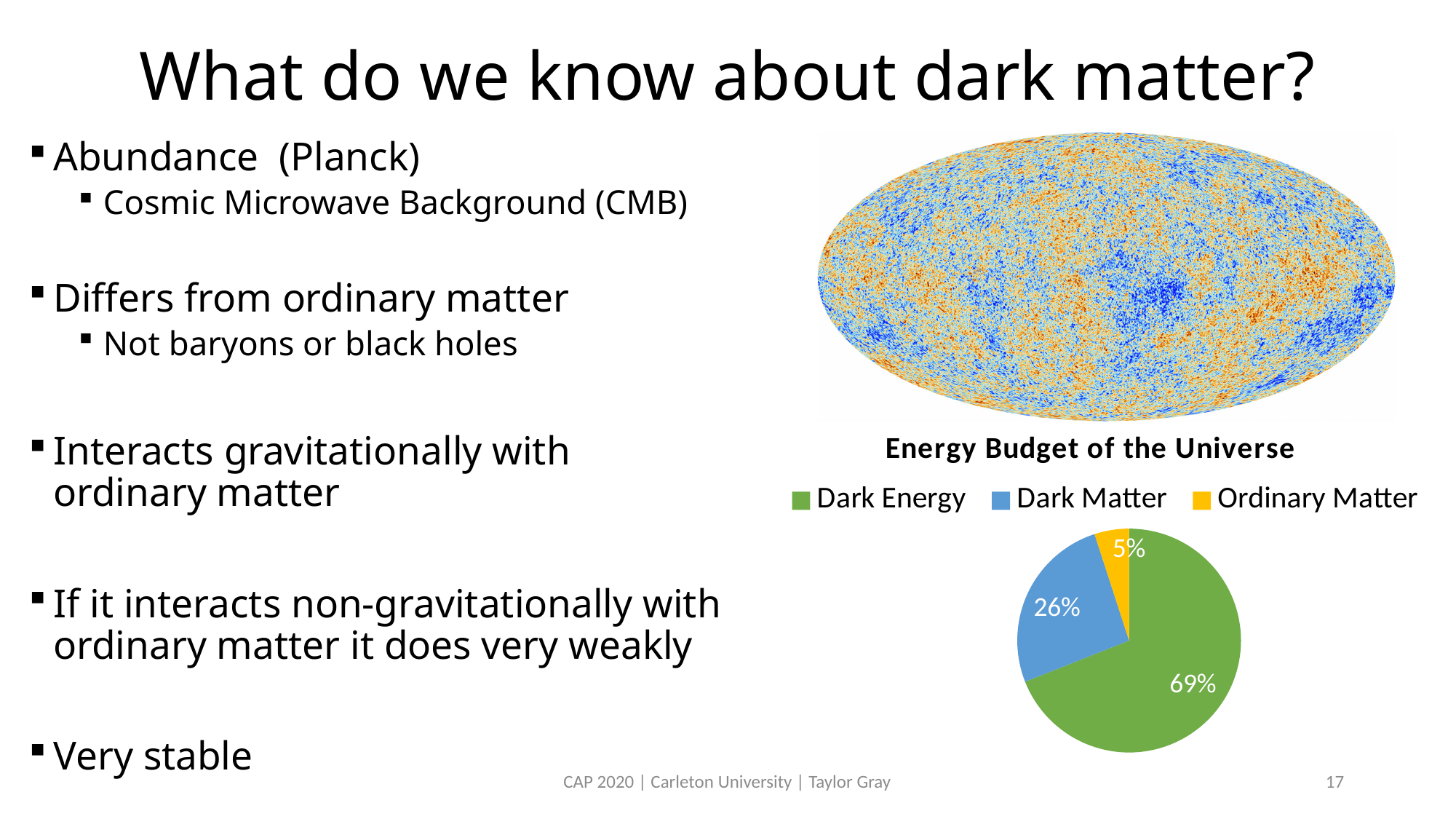
What is the difference between the Dark Matter and Ordinary Matter shares? 21% What share of the pie does Dark Matter take? 26% What colour represents Ordinary Matter in the pie chart? yellow What is the difference between the Dark Energy and Dark Matter shares? 43% What is the title of the pie chart? Energy Budget of the Universe Which category has the smallest slice of the pie? Ordinary Matter How many categories does the legend of the pie chart list? 3 Which is larger, the Dark Matter slice or the Ordinary Matter slice? Dark Matter What kind of chart is shown on the slide? pie chart What share of the pie does Ordinary Matter take? 5% Which category has the largest slice of the pie? Dark Energy What share of the pie does Dark Energy take? 69%